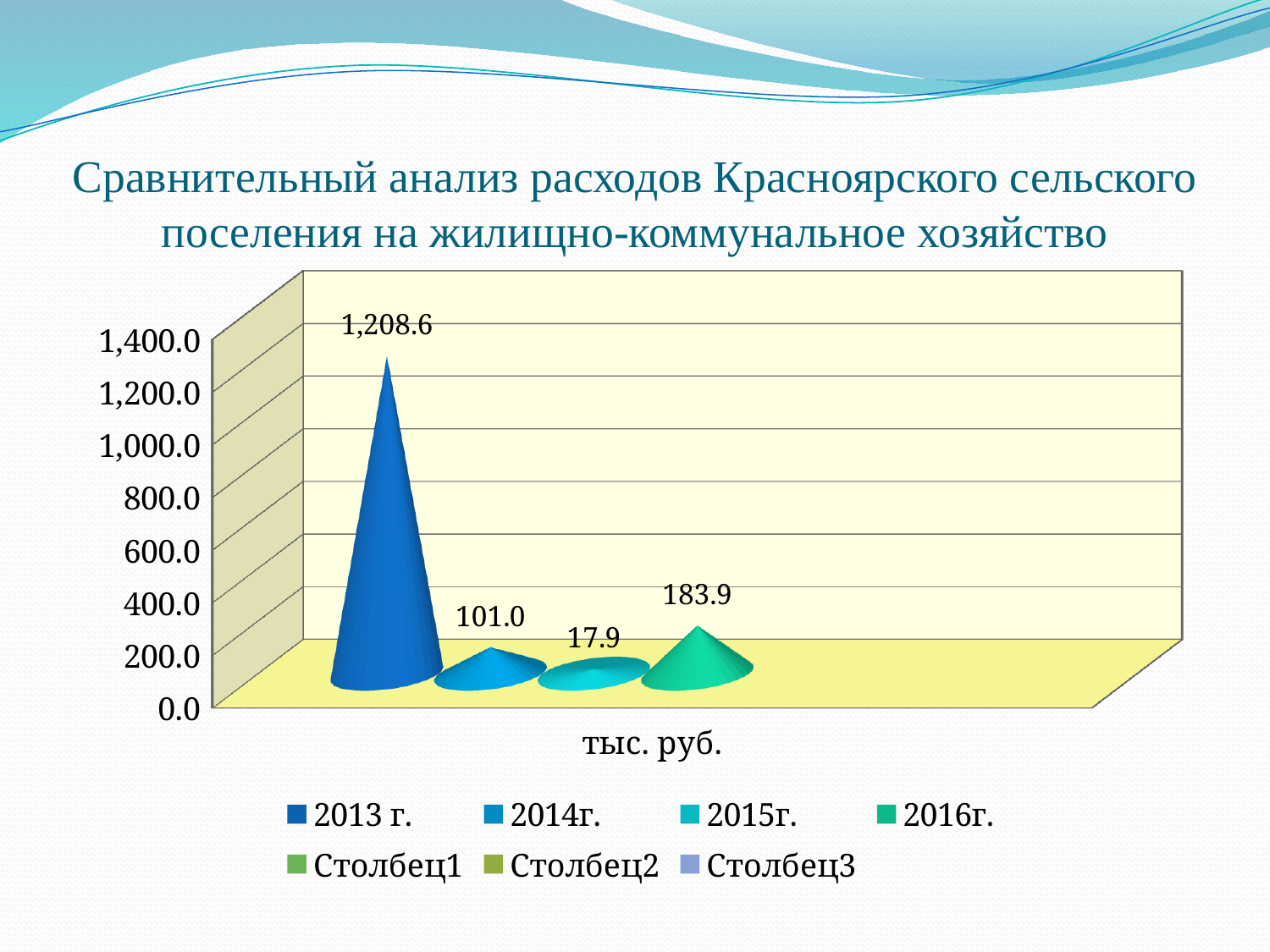
What unit label is shown below the chart's horizontal axis? тыс. руб. Which year has the highest value? 2013 г. What is the value for 2016г.? 183.9 What is the value for 2015г.? 17.9 Which is larger, the value for 2014г. or the value for 2016г.? 2016г. What is the value for 2014г.? 101.0 How many entries does the legend list? 7 What is the difference between the values for 2013 г. and 2016г.? 1,024.7 What kind of chart is shown on the slide? 3D bar chart (cone) What is the value for 2013 г.? 1,208.6 What is the difference between the values for 2016г. and 2014г.? 82.9 Which year has the lowest value? 2015г.